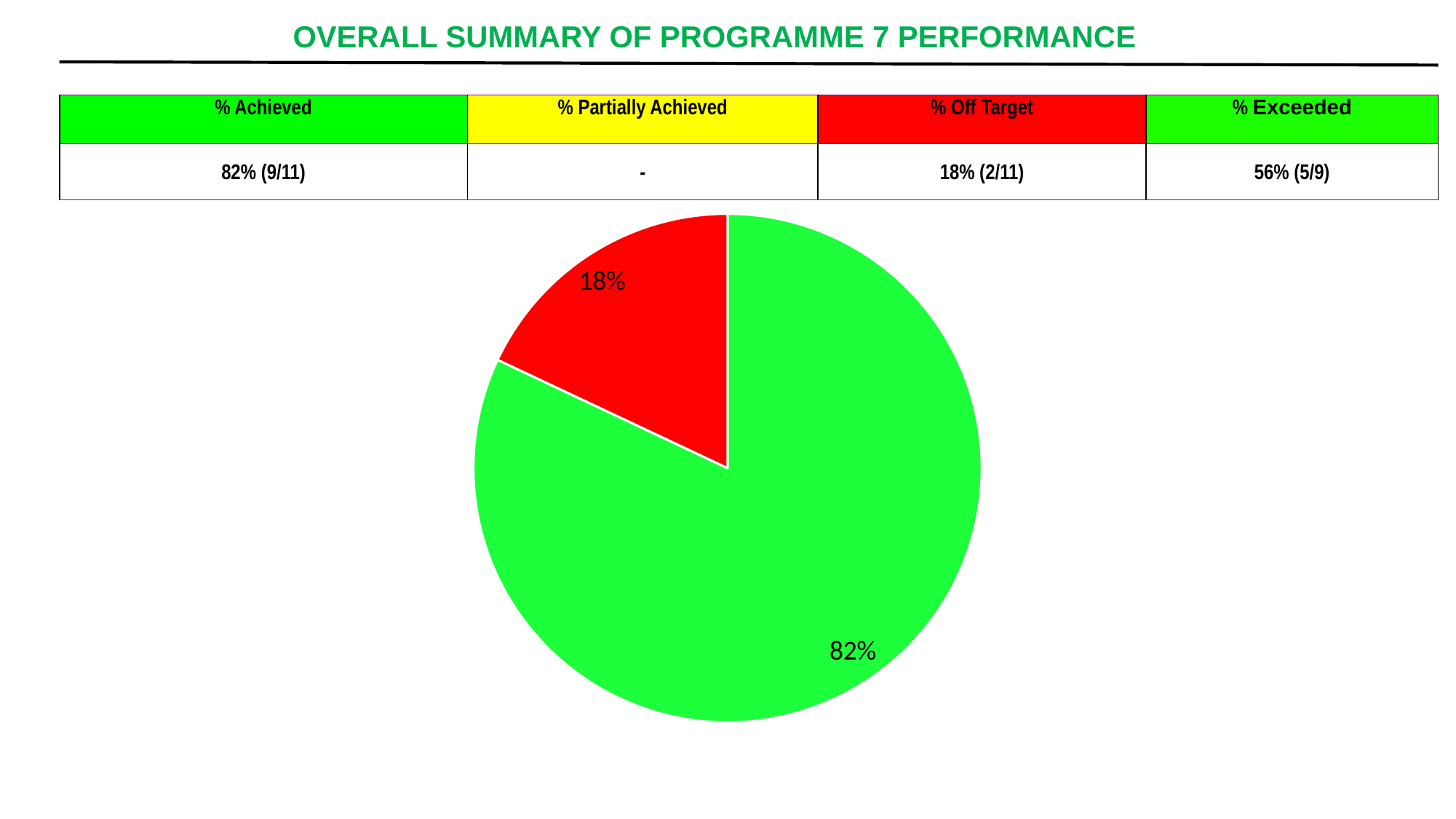
How many slices does the pie chart have? 2 What share of the pie does the green slice represent? 82% Which slice of the pie chart is the smallest? the red slice (18%) Is the share of the green slice greater or less than 75%? greater What share of the pie does the red slice represent? 18% What colour is the slice labelled 18%? red Which is larger, the green slice or the red slice? the green slice What is the title of the slide containing the pie chart? OVERALL SUMMARY OF PROGRAMME 7 PERFORMANCE Is the share of the red slice greater or less than 25%? less What kind of chart is shown on the slide? pie chart What is the difference in percentage points between the green slice and the red slice? 64 Which slice of the pie chart is the largest? the green slice (82%)